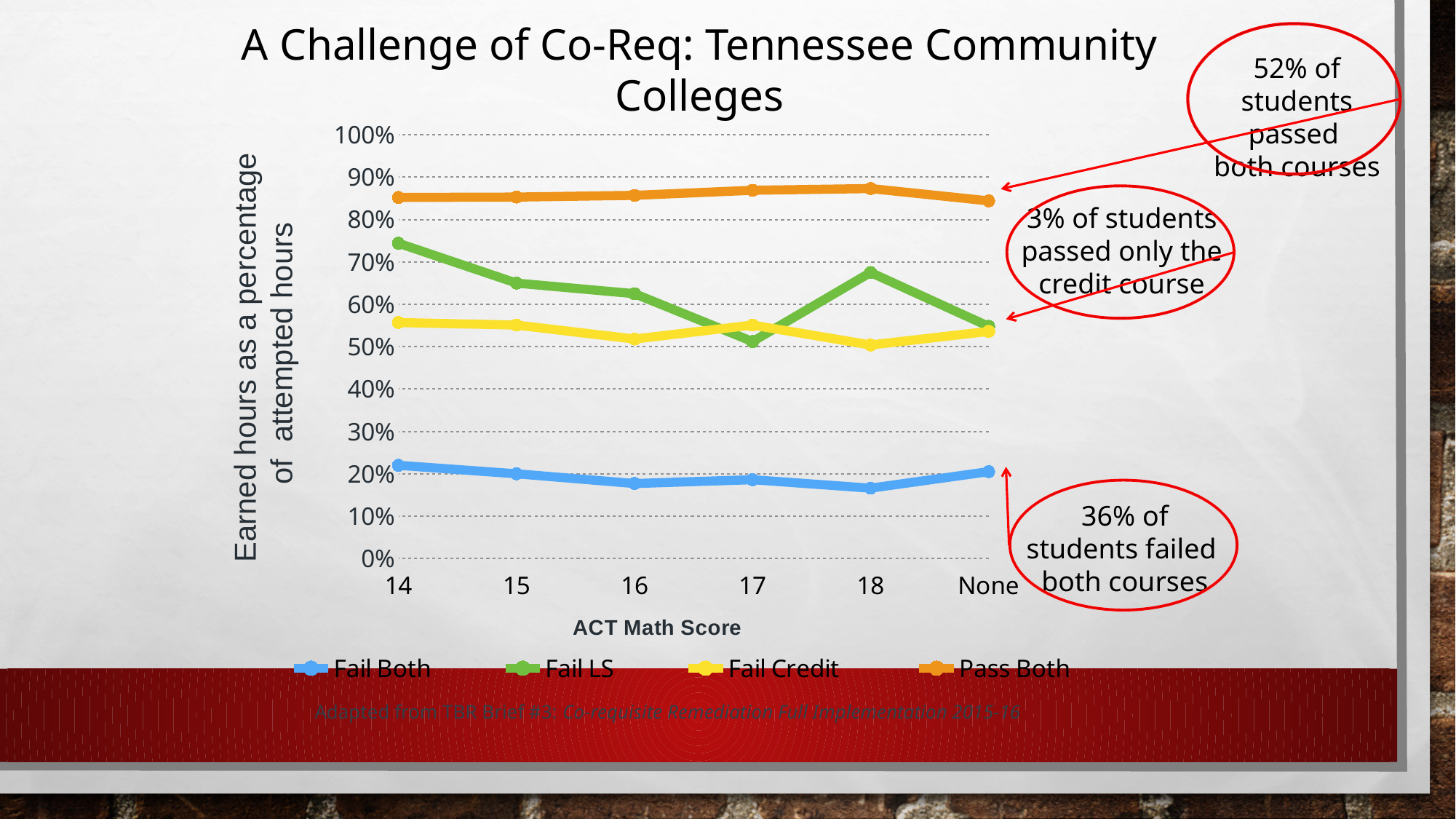
Does the Fail LS line rise or fall from an ACT Math Score of 14 to 16? fall Which series has the highest value at an ACT Math Score of 14? Pass Both At an ACT Math Score of 16, which is larger: Fail LS or Fail Credit? Fail LS How many series does the legend list? 4 Is the value for Pass Both at an ACT Math Score of 14 greater or less than 80%? greater Is the value for Fail LS at an ACT Math Score of 14 greater or less than 70%? greater Which series has the lowest value at an ACT Math Score of 18? Fail Both What kind of chart is shown on the slide? line chart How many ACT Math Score categories are shown on the x axis? 6 Is the value for Fail Both at an ACT Math Score of 18 greater or less than 20%? less At an ACT Math Score of 18, which is larger: Fail LS or Fail Credit? Fail LS What is the title of the x axis? ACT Math Score